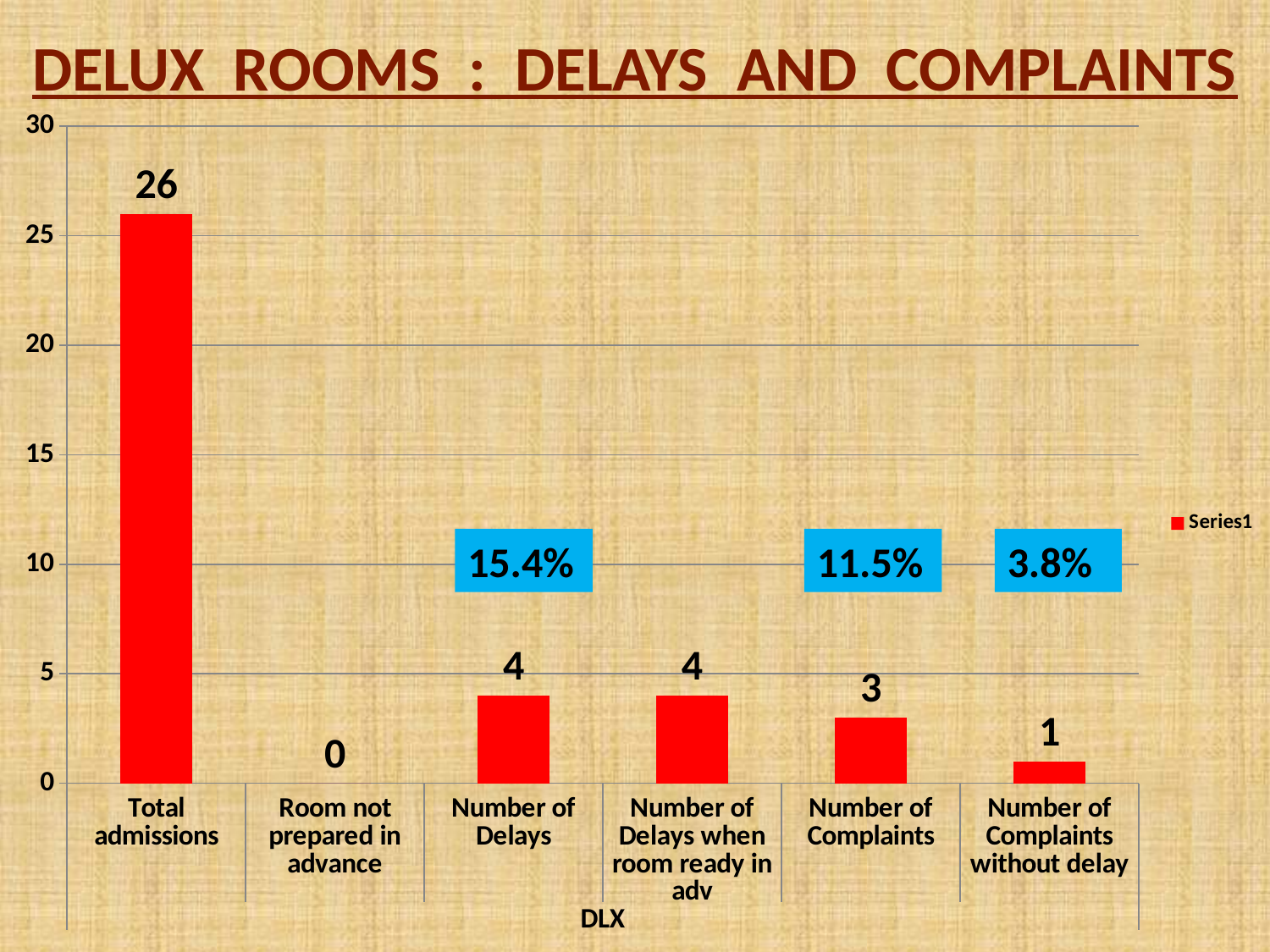
What is the value for Total admissions? 26 What percentage is shown in the blue box above the Number of Complaints bar? 11.5% What is the value for Number of Delays? 4 How many categories are shown on the x axis? 6 Which category has the highest value? Total admissions Which category has the lowest value? Room not prepared in advance What is the difference between Total admissions and Number of Delays? 22 Which is larger, Number of Complaints or Number of Complaints without delay? Number of Complaints What is the value for Number of Complaints? 3 What is the value for Room not prepared in advance? 0 What kind of chart is shown on the slide? Bar chart What is the value for Number of Complaints without delay? 1